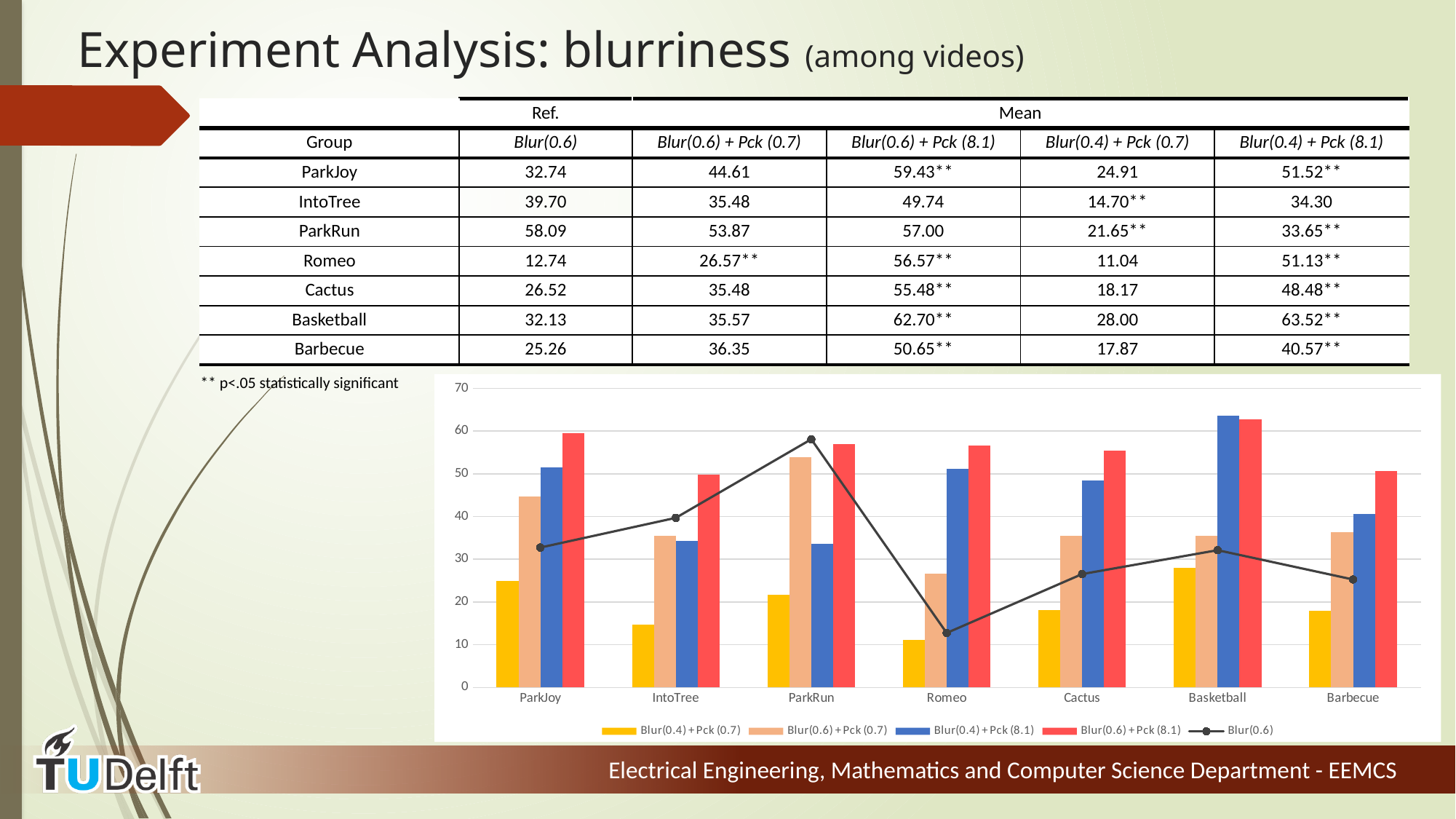
What kind of chart is shown on the slide? bar chart with a line series What is the Blur(0.6) + Pck (8.1) value for Basketball? 62.70 How many series does the chart legend list? 5 What colour are the Blur(0.6) + Pck (8.1) bars in the chart? red Which group has the highest value on the Blur(0.6) line? ParkRun Is the Blur(0.6) value for Romeo greater or less than 20? less What is the Blur(0.4) + Pck (0.7) value for Romeo? 11.04 Which group has the highest Blur(0.6) + Pck (8.1) value? Basketball How many video groups are shown along the x axis of the chart? 7 Is the Blur(0.4) + Pck (8.1) value for Basketball greater or less than 60? greater For ParkRun, which is larger: Blur(0.6) + Pck (0.7) or Blur(0.4) + Pck (8.1)? Blur(0.6) + Pck (0.7) Which group has the lowest Blur(0.4) + Pck (0.7) value? Romeo